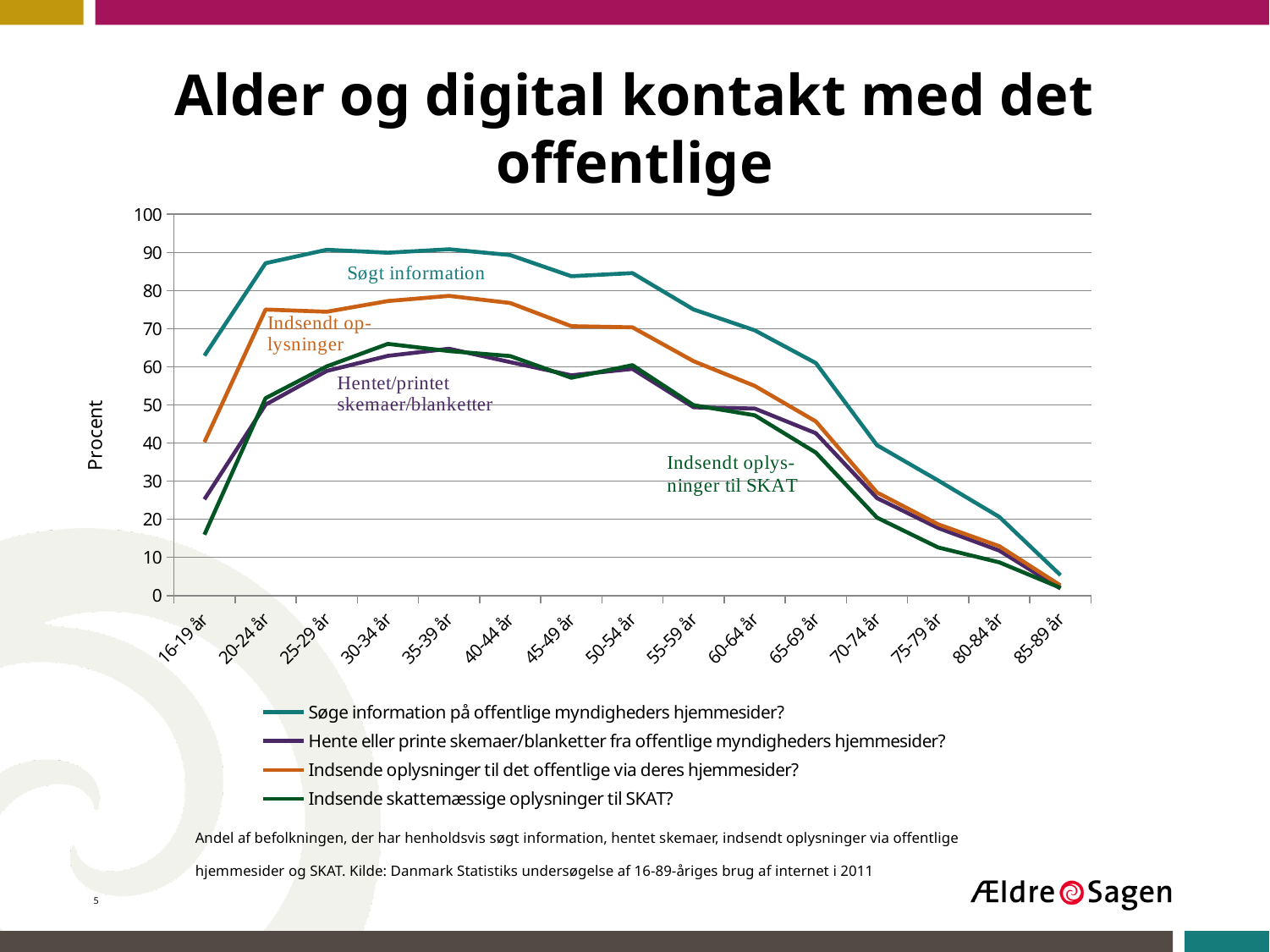
Which series is the highest for the 40-44 år age group? Søge information på offentlige myndigheders hjemmesider? Is the value for 'Søge information på offentlige myndigheders hjemmesider?' at 16-19 år greater or less than 50? greater Is the value for 'Indsende skattemæssige oplysninger til SKAT?' at 16-19 år greater or less than 20? less Is the value for 'Søge information på offentlige myndigheders hjemmesider?' at 85-89 år greater or less than 10? less Which series is the lowest for the 16-19 år age group? Indsende skattemæssige oplysninger til SKAT? What is the label on the vertical axis? Procent At 65-69 år, which is larger: 'Søge information på offentlige myndigheders hjemmesider?' or 'Indsende skattemæssige oplysninger til SKAT?'? Søge information på offentlige myndigheders hjemmesider? For which age group is the value of 'Søge information på offentlige myndigheders hjemmesider?' lowest? 85-89 år How many series does the legend list? 4 How many age groups are shown along the x axis? 15 From 50-54 år to 85-89 år, do the values for 'Søge information på offentlige myndigheders hjemmesider?' rise or fall? fall What kind of chart is shown on the slide? line chart